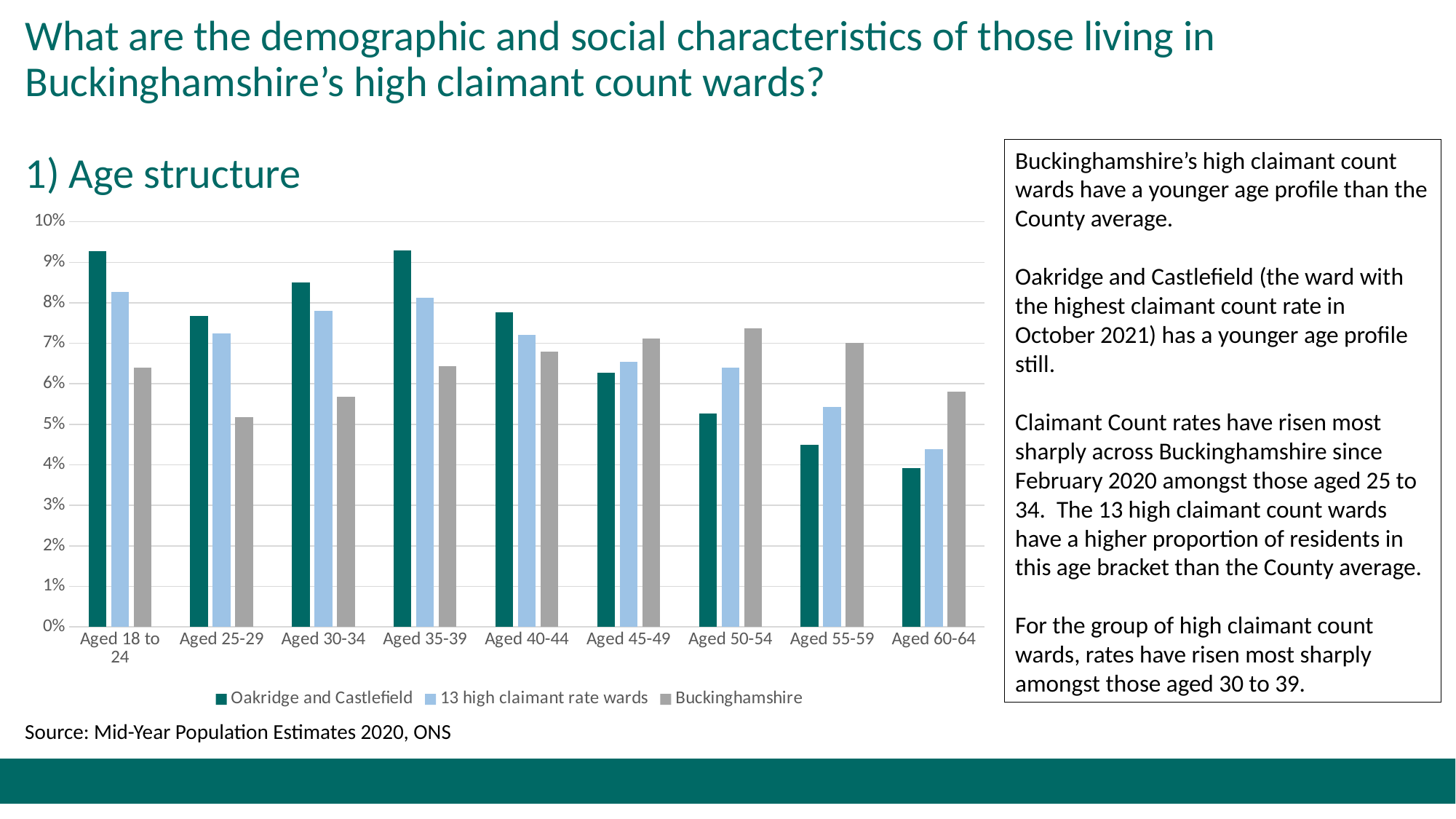
Is the value for Oakridge and Castlefield in the Aged 18 to 24 group greater or less than 8%? greater Is the value for the 13 high claimant rate wards in the Aged 60-64 group greater or less than 5%? less What kind of chart is shown on the slide? Bar chart For Oakridge and Castlefield, do the values rise or fall from Aged 40-44 to Aged 60-64? fall Which age group has the lowest value for the 13 high claimant rate wards? Aged 60-64 How many series does the chart's legend list? 3 In the Aged 25-29 group, which is larger: Oakridge and Castlefield or Buckinghamshire? Oakridge and Castlefield Which age group has the lowest value for Oakridge and Castlefield? Aged 60-64 How many age groups are shown on the x axis of the chart? 9 In the Aged 45-49 group, which is larger: Oakridge and Castlefield or Buckinghamshire? Buckinghamshire Which age group has the lowest value for Buckinghamshire? Aged 25-29 Is the value for Buckinghamshire in the Aged 25-29 group greater or less than 6%? less